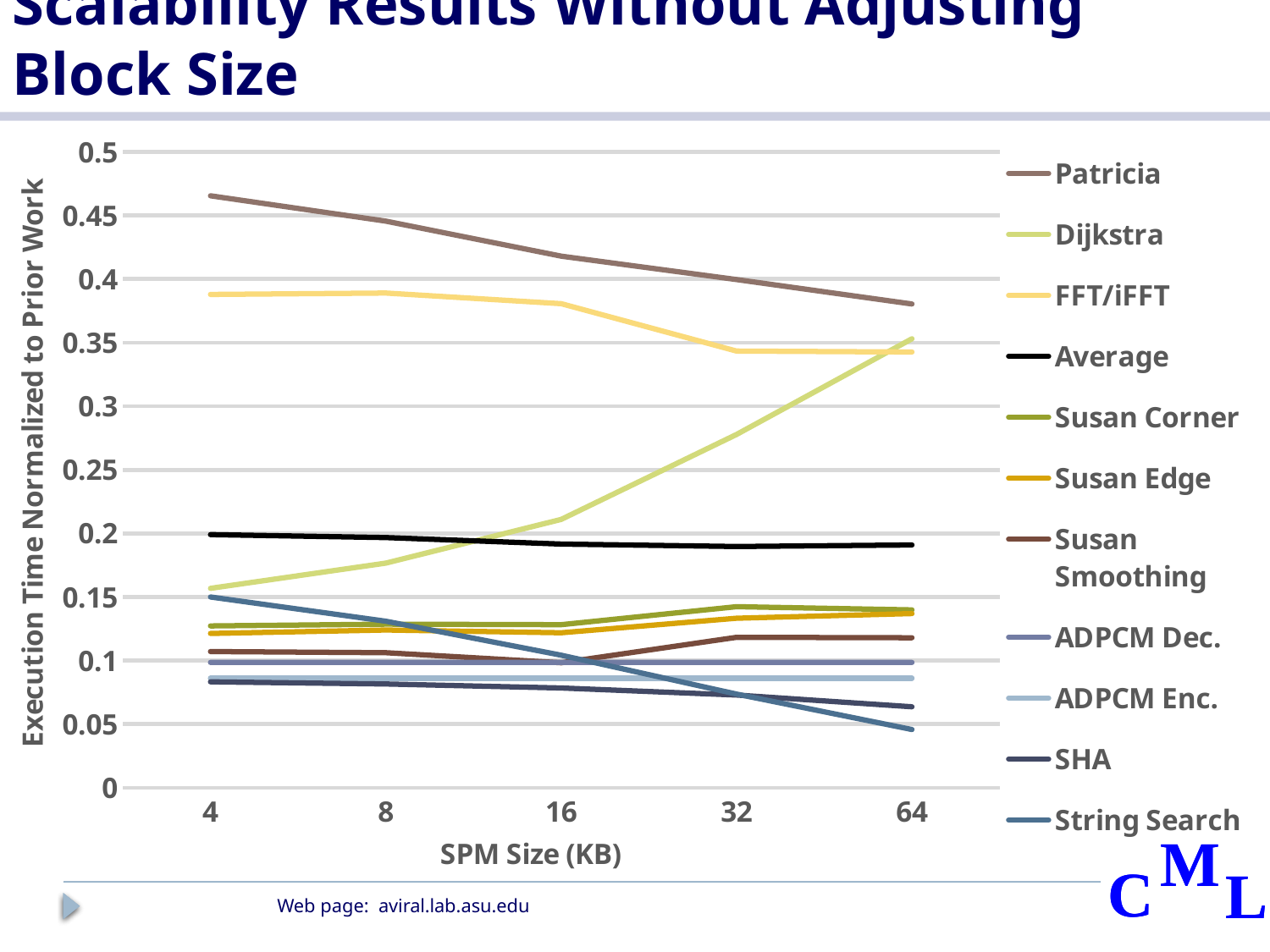
At an SPM size of 64 KB, which is larger: Dijkstra or Average? Dijkstra Is the value for String Search at 64 KB greater or less than 0.1? less What is the title of the x axis? SPM Size (KB) Which series has the highest value at an SPM size of 4 KB? Patricia Is the value for Dijkstra at 64 KB greater or less than 0.3? greater Does the Dijkstra line rise or fall as SPM size increases from 4 to 64 KB? Rises How many SPM size points are plotted along the x axis? 5 How many series does the legend list? 11 Which series has the lowest value at an SPM size of 64 KB? String Search Does the Patricia line rise or fall as SPM size increases from 4 to 64 KB? Falls What kind of chart is shown on the slide? Line chart Is the value for Patricia at 4 KB greater or less than 0.4? greater